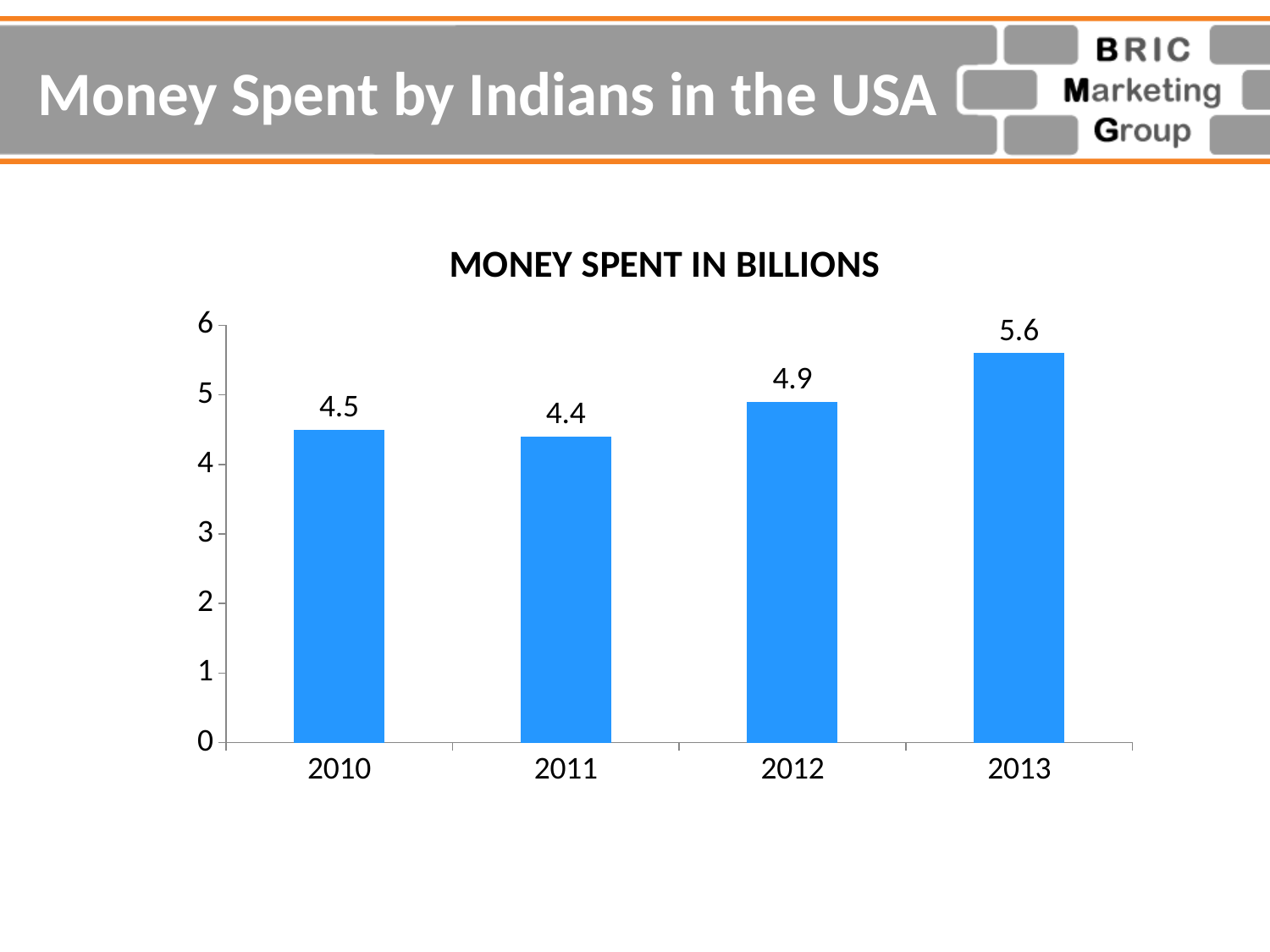
Is the value for 2013 greater or less than 5? greater What kind of chart is shown? bar chart Which year has the highest value? 2013 Which year has the lowest value? 2011 What is the difference between the values for 2013 and 2010? 1.1 Which is larger, the value for 2012 or the value for 2011? 2012 What is the value for 2012? 4.9 What is the value for 2013? 5.6 What is the title of the chart? MONEY SPENT IN BILLIONS What is the value for 2010? 4.5 What is the value for 2011? 4.4 How many years are shown on the x axis? 4